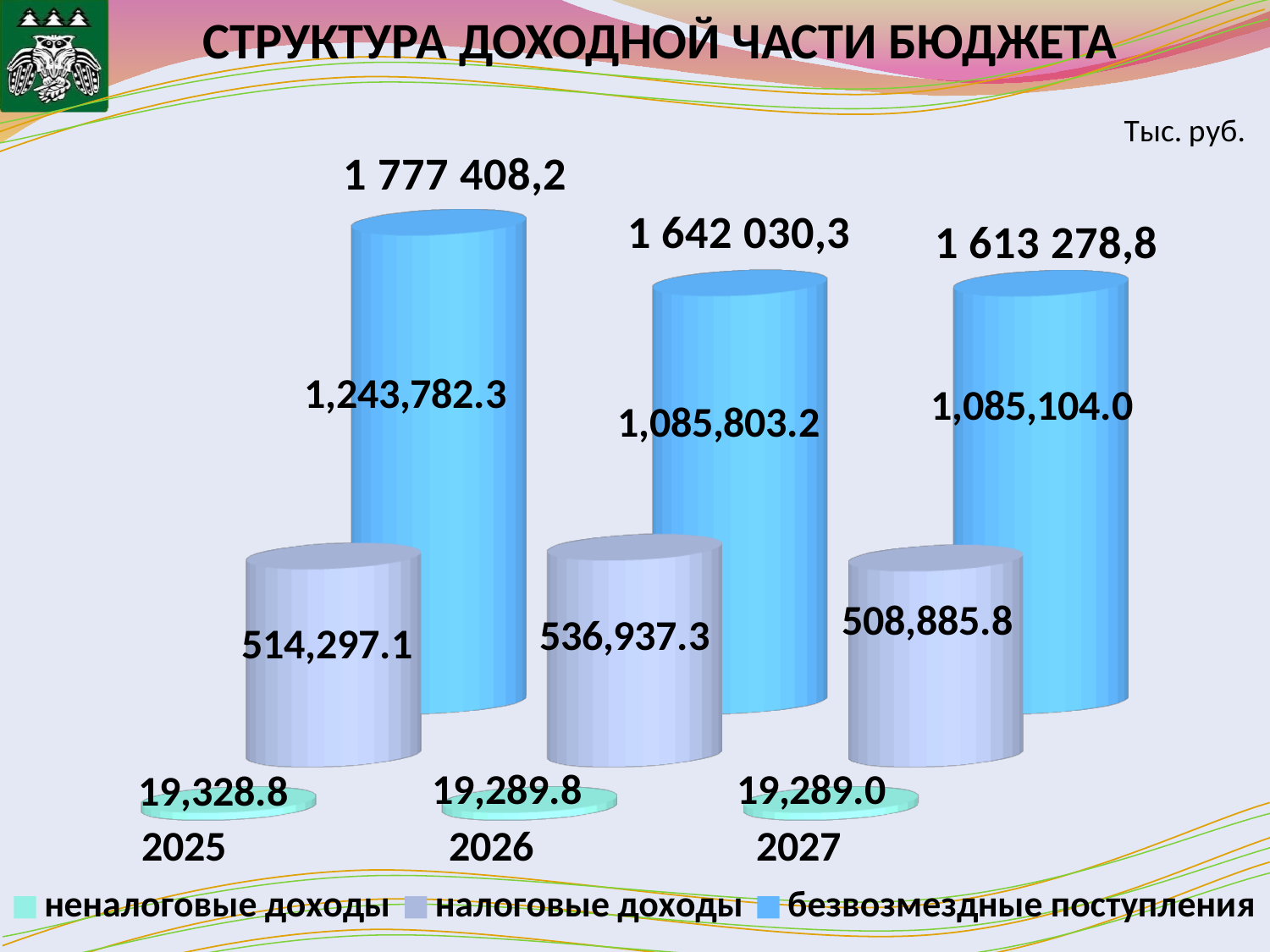
What is the total budget revenue shown above the bars for 2026? 1 642 030,3 What is the value of безвозмездные поступления for 2025? 1,243,782.3 How many series does the legend list? 3 In which year are налоговые доходы the lowest? 2027 What is the difference between налоговые доходы in 2026 and in 2025? 22,640.2 What is the value of налоговые доходы for 2026? 536,937.3 What is the value of неналоговые доходы for 2027? 19,289.0 Do the total revenues shown above the bars rise or fall from 2025 to 2027? fall In which year are безвозмездные поступления the highest? 2025 How many years are shown on the x axis? 3 What kind of chart is shown on the slide? bar chart Which is larger: налоговые доходы in 2026 or in 2027? 2026